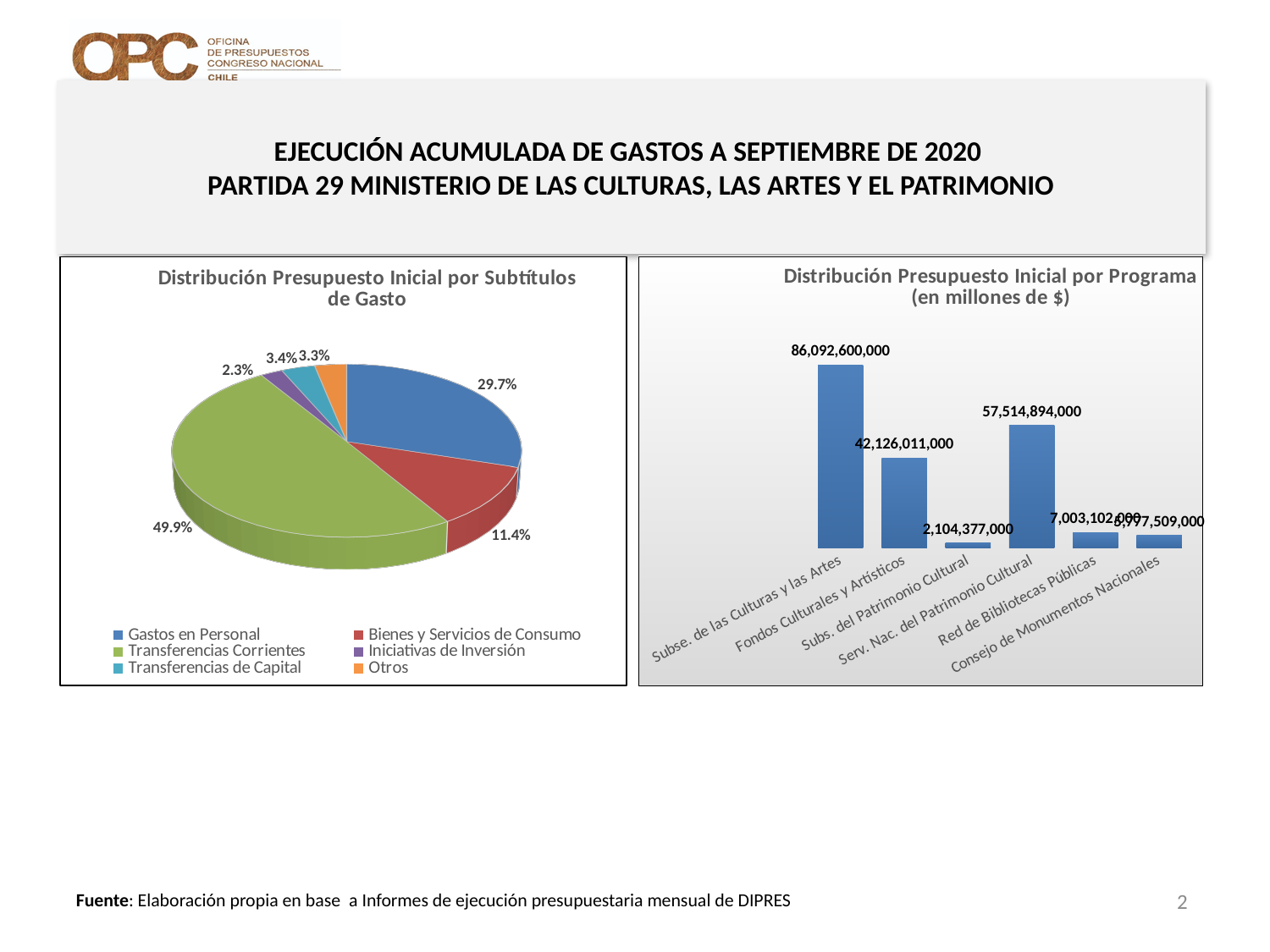
In the pie chart 'Distribución Presupuesto Inicial por Subtítulos de Gasto', which category has the smallest slice? Iniciativas de Inversión In the chart 'Distribución Presupuesto Inicial por Programa', what is the value for Fondos Culturales y Artísticos? 42,126,011,000 What kind of chart is 'Distribución Presupuesto Inicial por Programa'? Bar chart In the chart 'Distribución Presupuesto Inicial por Programa', which program has the lowest value? Subs. del Patrimonio Cultural In the chart 'Distribución Presupuesto Inicial por Programa', which program has the highest value? Subse. de las Culturas y las Artes In the pie chart 'Distribución Presupuesto Inicial por Subtítulos de Gasto', which category has the largest slice? Transferencias Corrientes In the pie chart 'Distribución Presupuesto Inicial por Subtítulos de Gasto', how many categories does the legend list? 6 In the pie chart 'Distribución Presupuesto Inicial por Subtítulos de Gasto', what percentage is shown for Gastos en Personal? 29.7% In the chart 'Distribución Presupuesto Inicial por Programa', how many programs are plotted? 6 In the chart 'Distribución Presupuesto Inicial por Programa', what is the value for Serv. Nac. del Patrimonio Cultural? 57,514,894,000 In the pie chart 'Distribución Presupuesto Inicial por Subtítulos de Gasto', what is the difference in percentage points between Gastos en Personal and Bienes y Servicios de Consumo? 18.3 percentage points In the pie chart 'Distribución Presupuesto Inicial por Subtítulos de Gasto', what share does Transferencias Corrientes have? 49.9%